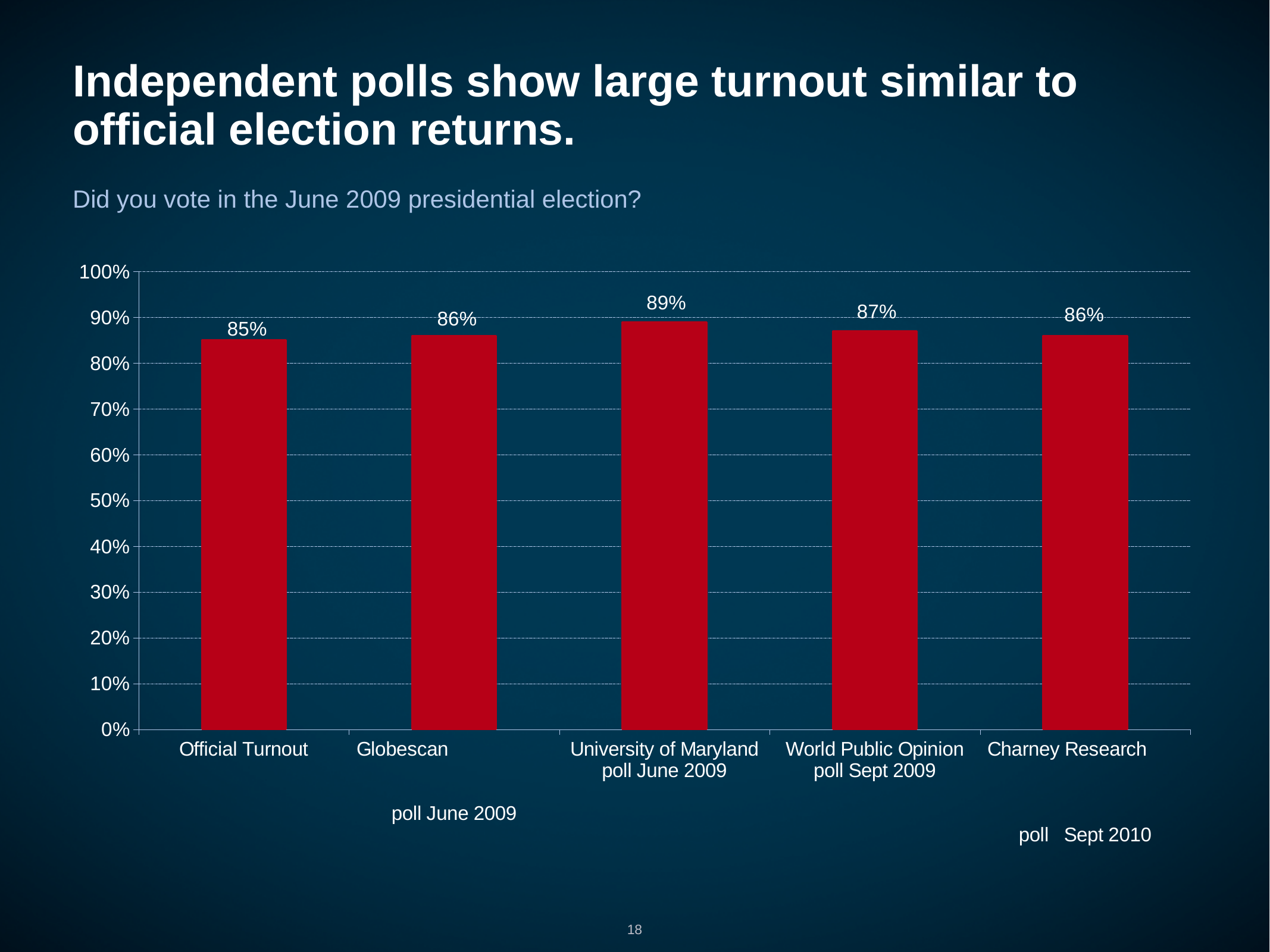
How many bars are shown in the chart? 5 What is the value for University of Maryland poll June 2009? 89% What is the difference between the University of Maryland poll June 2009 value and the Official Turnout value? 4% Which is larger, the value for World Public Opinion poll Sept 2009 or the value for Globescan? World Public Opinion poll Sept 2009 What question is the chart based on, as shown above the chart? Did you vote in the June 2009 presidential election? What is the value for Charney Research? 86% Which category has the highest value? University of Maryland poll June 2009 Which category has the lowest value? Official Turnout What is the value for Globescan? 86% What is the value for Official Turnout? 85% What is the value for World Public Opinion poll Sept 2009? 87% What kind of chart is shown on the slide? Bar chart